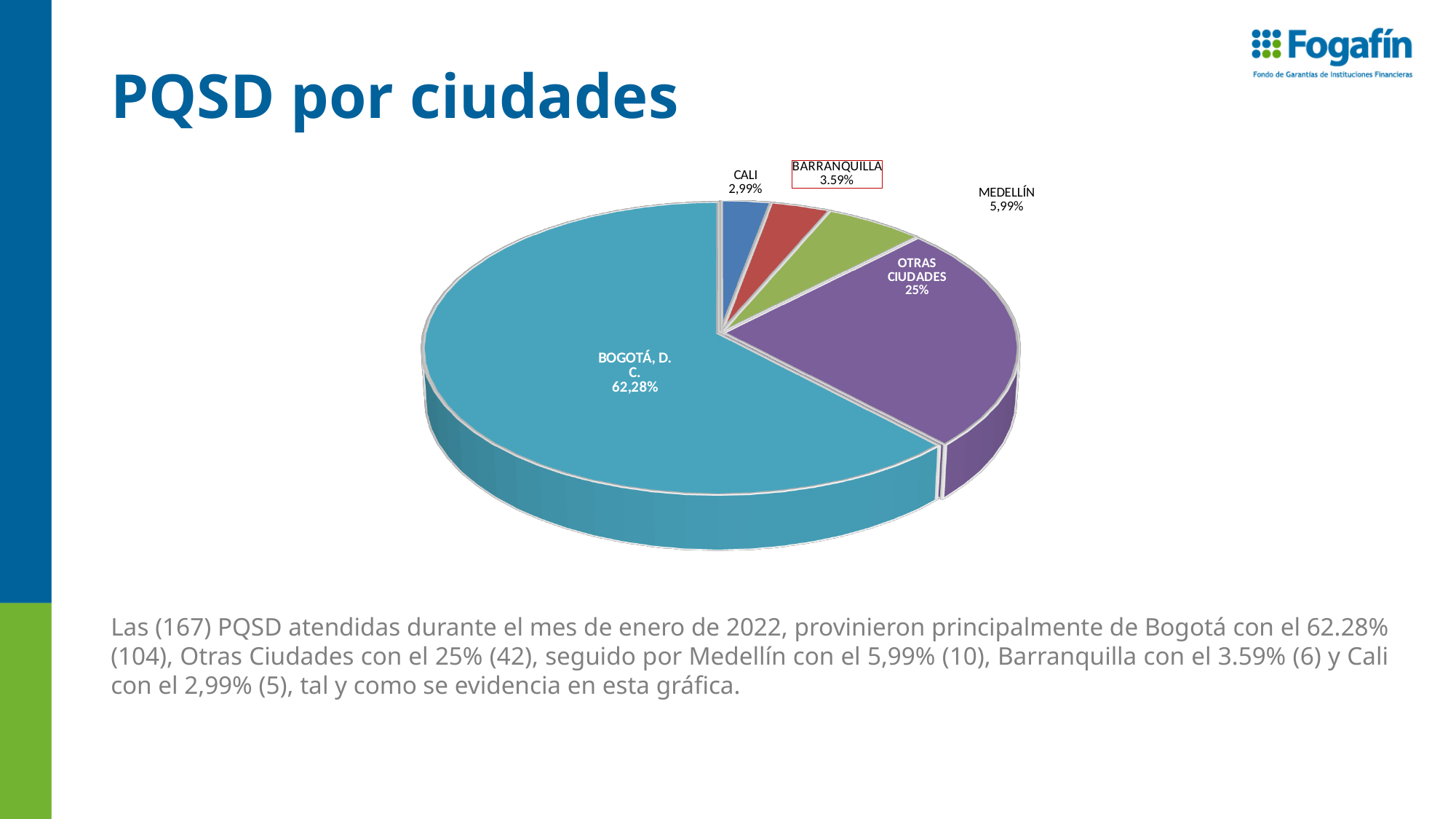
What percentage does the BOGOTÁ, D. C. slice show? 62,28% What kind of chart is shown on the slide? Pie chart What percentage is shown for OTRAS CIUDADES? 25% What percentage is shown for BARRANQUILLA? 3.59% What percentage is shown for CALI? 2,99% How many slices does the pie chart have? 5 What percentage is shown for MEDELLÍN? 5,99% What is the difference in percentage points between BOGOTÁ, D. C. and OTRAS CIUDADES? 37,28% Which city has the smallest slice of the pie? CALI Which city has the largest slice of the pie? BOGOTÁ, D. C. What is the title of the slide containing the chart? PQSD por ciudades Which slice is larger, MEDELLÍN or BARRANQUILLA? MEDELLÍN